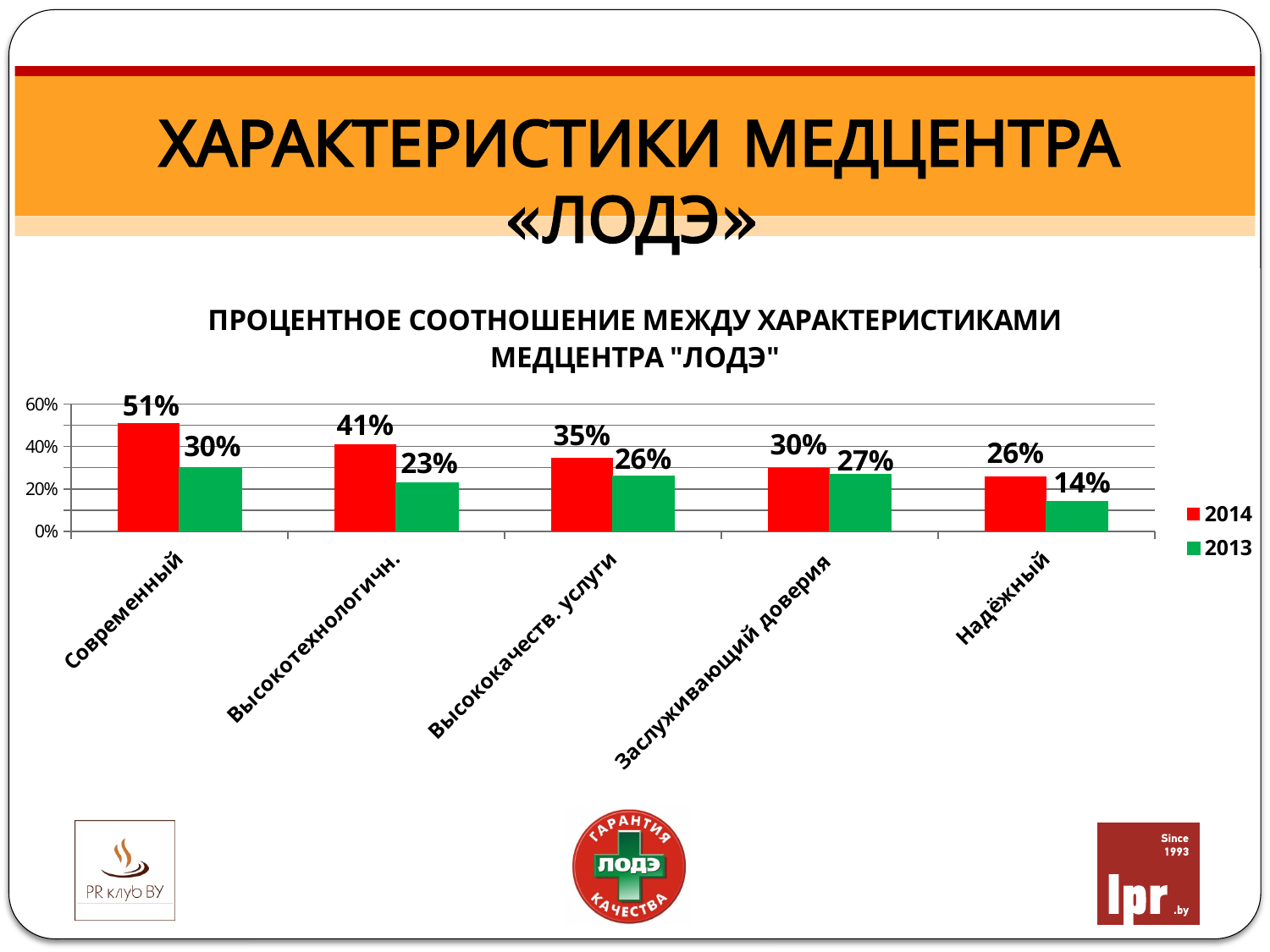
Which is larger: the 2014 value for Высококачеств. услуги or the 2014 value for Заслуживающий доверия? Высококачеств. услуги What kind of chart is shown on the slide? Bar chart How many categories are shown on the x axis? 5 Do the 2014 values rise or fall from left to right across the categories? Fall Which category has the highest 2014 value? Современный What is the 2013 value for Надёжный? 14% What is the difference between the 2014 and 2013 values for Заслуживающий доверия? 3% What is the 2013 value for Высокотехнологичн.? 23% How many series does the legend list? 2 What is the difference between the 2014 and 2013 values for Современный? 21% What is the 2014 value for Современный? 51% Which category has the lowest 2013 value? Надёжный